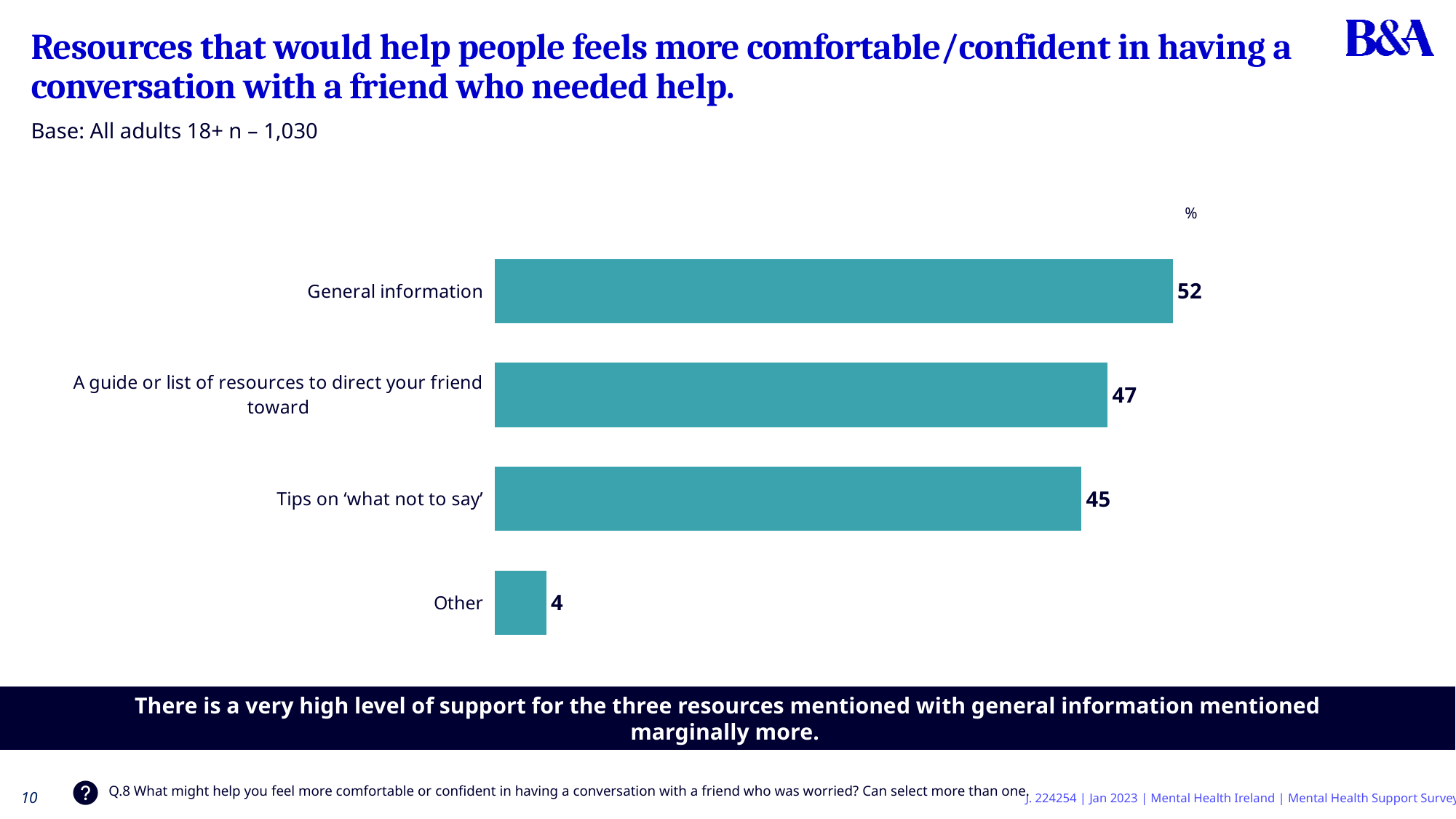
Which category has the lowest value? Other What is the value for General information? 52 What is the value for Tips on 'what not to say'? 45 What is the difference between the values for General information and Tips on 'what not to say'? 7 What is the value for A guide or list of resources to direct your friend toward? 47 How many categories are shown in the chart? 4 What is the difference between the values for A guide or list of resources to direct your friend toward and Other? 43 Which category has the highest value? General information What kind of chart is shown on the slide? Bar chart What is the base sample size stated on the slide? All adults 18+ n – 1,030 Which is larger, the value for A guide or list of resources to direct your friend toward or the value for Tips on 'what not to say'? A guide or list of resources to direct your friend toward What is the value for Other? 4